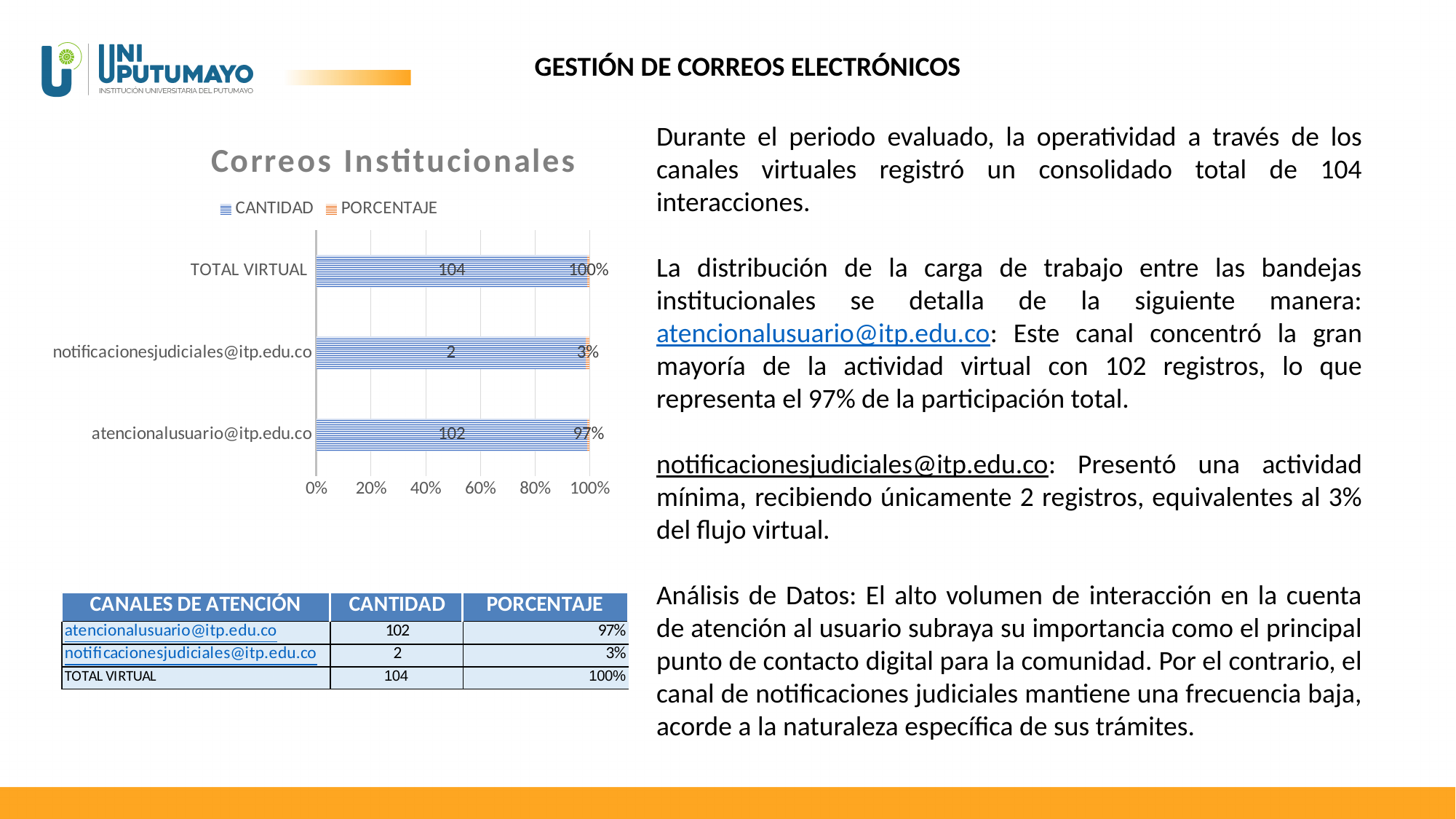
What is the PORCENTAJE value for atencionalusuario@itp.edu.co? 97% How many series does the chart legend list? 2 Which email channel has the lowest CANTIDAD value? notificacionesjudiciales@itp.edu.co What is the CANTIDAD value for atencionalusuario@itp.edu.co? 102 What are the two series names shown in the chart legend? CANTIDAD and PORCENTAJE What is the CANTIDAD value for TOTAL VIRTUAL? 104 How many categories are shown on the chart's vertical axis? 3 What is the PORCENTAJE value for notificacionesjudiciales@itp.edu.co? 3% What type of chart is shown on the slide? bar chart What is the difference in CANTIDAD between atencionalusuario@itp.edu.co and notificacionesjudiciales@itp.edu.co? 100 Which of the two email channels has the higher CANTIDAD value, atencionalusuario@itp.edu.co or notificacionesjudiciales@itp.edu.co? atencionalusuario@itp.edu.co What is the title of the chart? Correos Institucionales